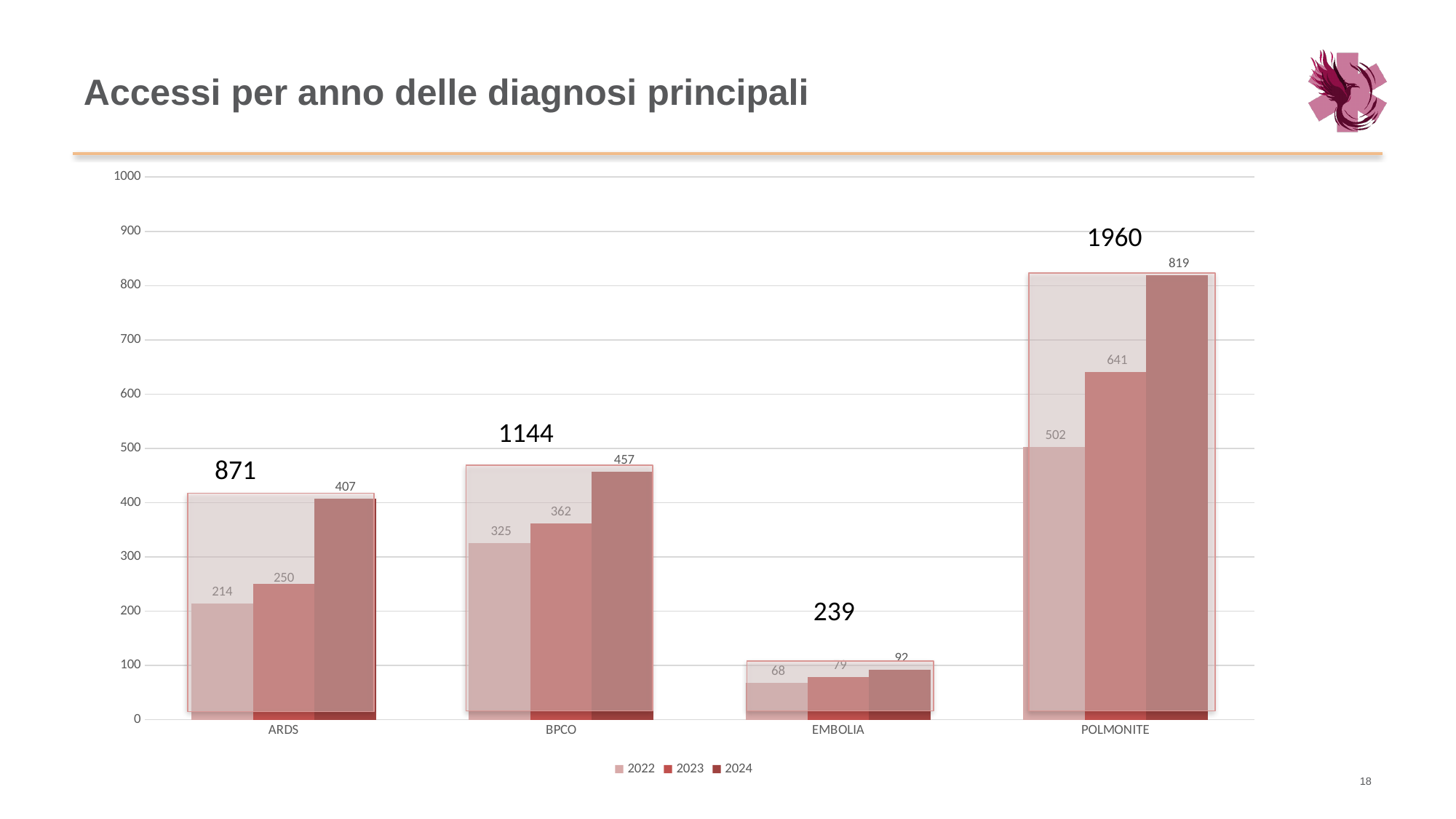
What is the value for ARDS in 2022? 214 How many categories are shown on the x axis? 4 What is the value for EMBOLIA in 2024? 92 Which category has the highest value in 2024? POLMONITE Which is larger: the 2024 value for ARDS or the 2023 value for BPCO? 2024 value for ARDS What kind of chart is shown? Bar chart How many series does the legend list? 3 What is the difference between the 2024 and 2022 values for POLMONITE? 317 What is the value for BPCO in 2023? 362 Which category has the lowest value in 2022? EMBOLIA What is the value for POLMONITE in 2024? 819 Do the values for BPCO rise or fall from 2022 to 2024? Rise